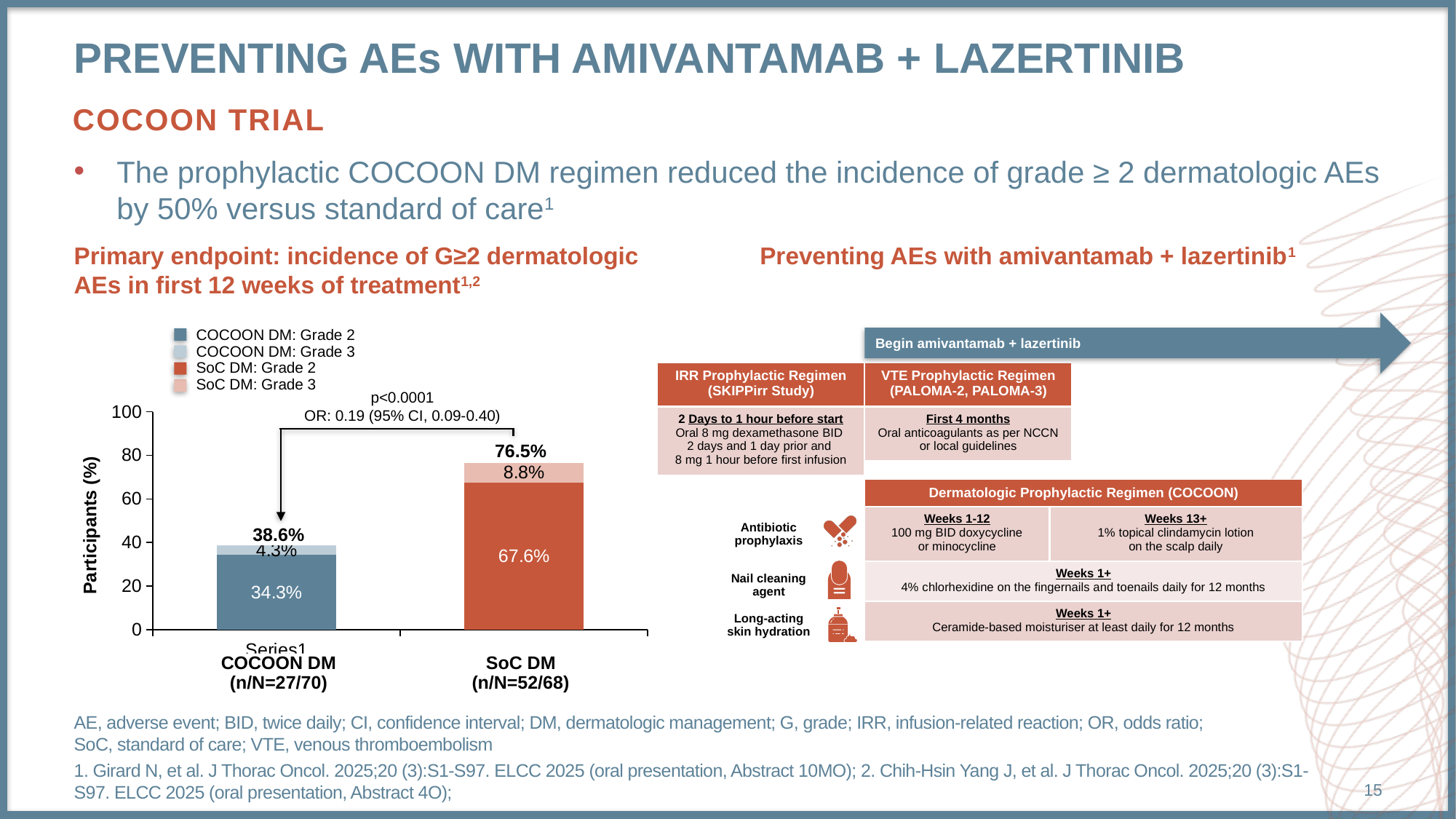
What is the label of the y axis? Participants (%) What is the total incidence shown for the SoC DM bar? 76.5% What is the Grade 3 value for SoC DM? 8.8% Which group has the higher total incidence of G≥2 dermatologic AEs? SoC DM Is the total value for COCOON DM greater or less than 40? less How many entries does the chart legend list? 4 What is the Grade 2 value for COCOON DM? 34.3% What type of chart is shown on the slide? bar chart What is the Grade 2 value for SoC DM? 67.6% What is the Grade 3 value for COCOON DM? 4.3% What is the difference between the total for SoC DM and the total for COCOON DM? 37.9% What is the total incidence shown for the COCOON DM bar? 38.6%